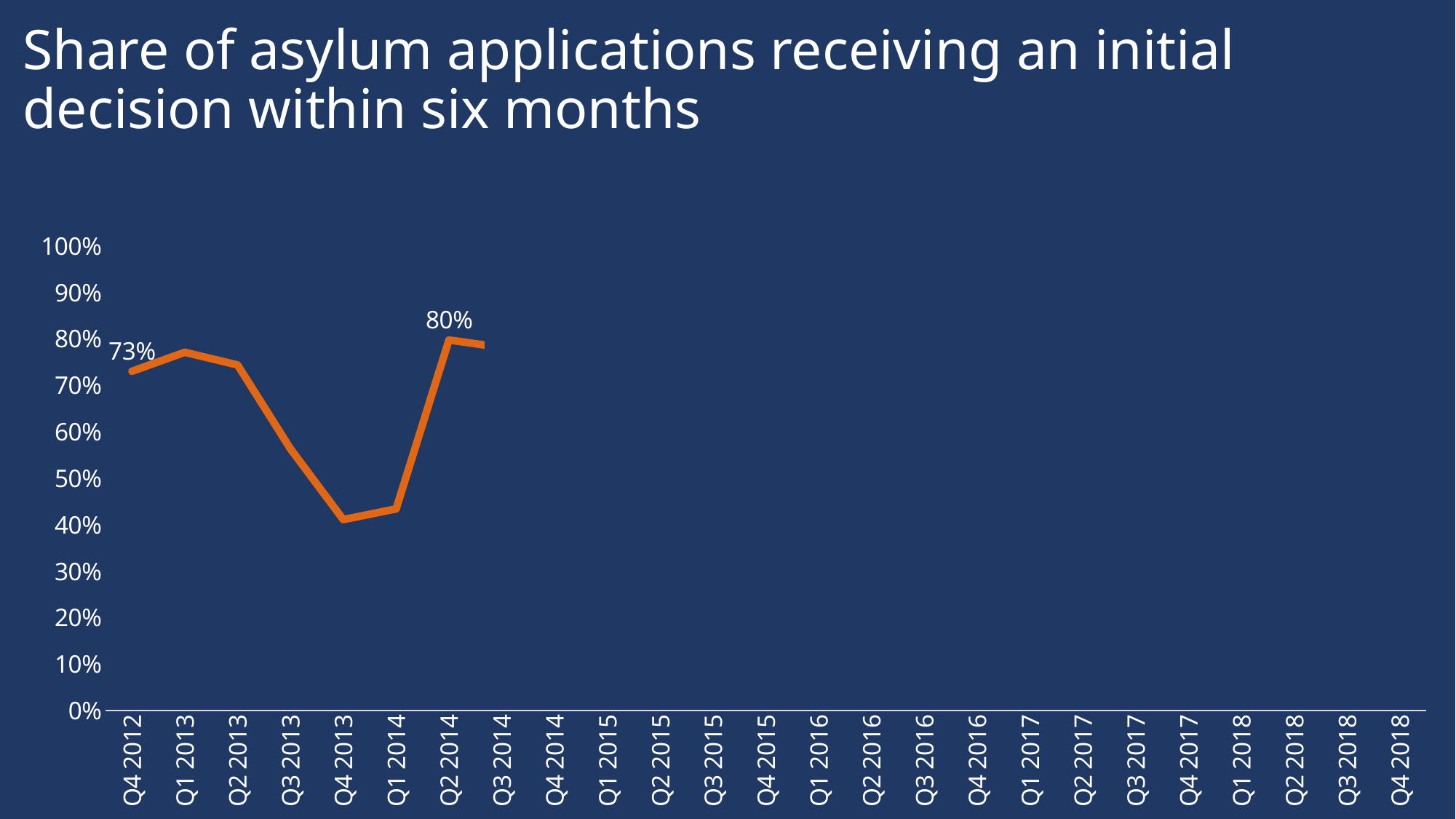
Which quarter has the highest value on the line? Q2 2014 Which is larger, the value for Q4 2012 or the value for Q2 2014? Q2 2014 What kind of chart is shown on the slide? line chart Is the value for Q3 2013 greater or less than 50%? greater Is the value for Q4 2013 greater or less than 50%? less Does the line rise or fall from Q2 2013 to Q4 2013? fall Which quarter has the lowest value on the line? Q4 2013 What is the value for Q2 2014? 80% What is the title of the chart? Share of asylum applications receiving an initial decision within six months What is the difference between the value for Q2 2014 and the value for Q4 2012? 7 percentage points What is the value for Q4 2012? 73% Is the value for Q1 2013 greater or less than 70%? greater